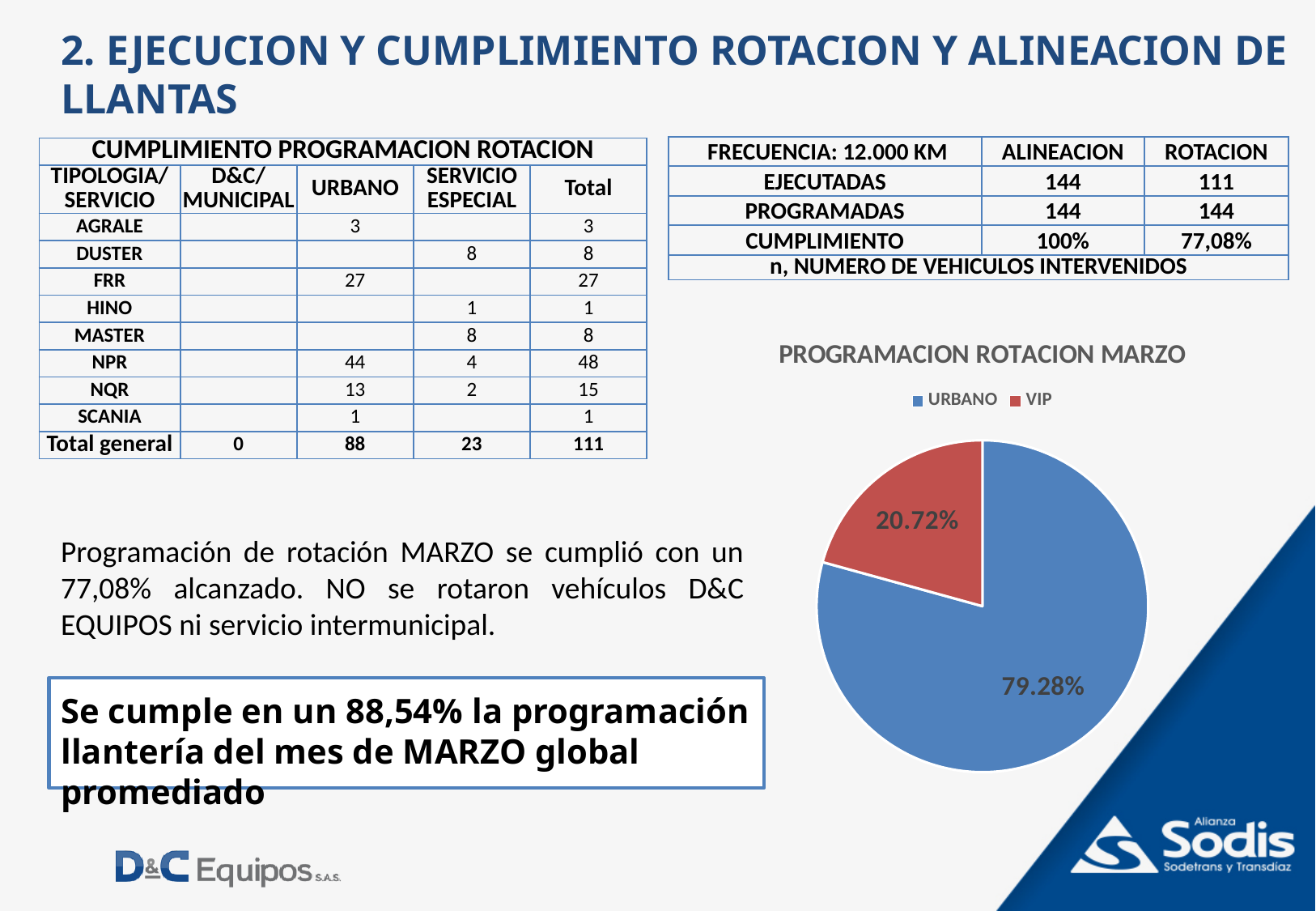
What share of the pie chart does VIP represent? 20.72% How many slices does the pie chart have? 2 What is the title of the pie chart? PROGRAMACION ROTACION MARZO What share of the pie chart does URBANO represent? 79.28% What is the difference in percentage points between the URBANO and VIP slices in the pie chart? 58.56% What is the value printed on the blue slice of the pie chart? 79.28% How many entries does the legend of the pie chart list? 2 Which category has the smallest slice in the pie chart? VIP In the pie chart, which is larger, URBANO or VIP? URBANO What colour is the VIP slice in the pie chart? red What kind of chart is shown on the slide? pie chart Which category has the largest slice in the pie chart? URBANO